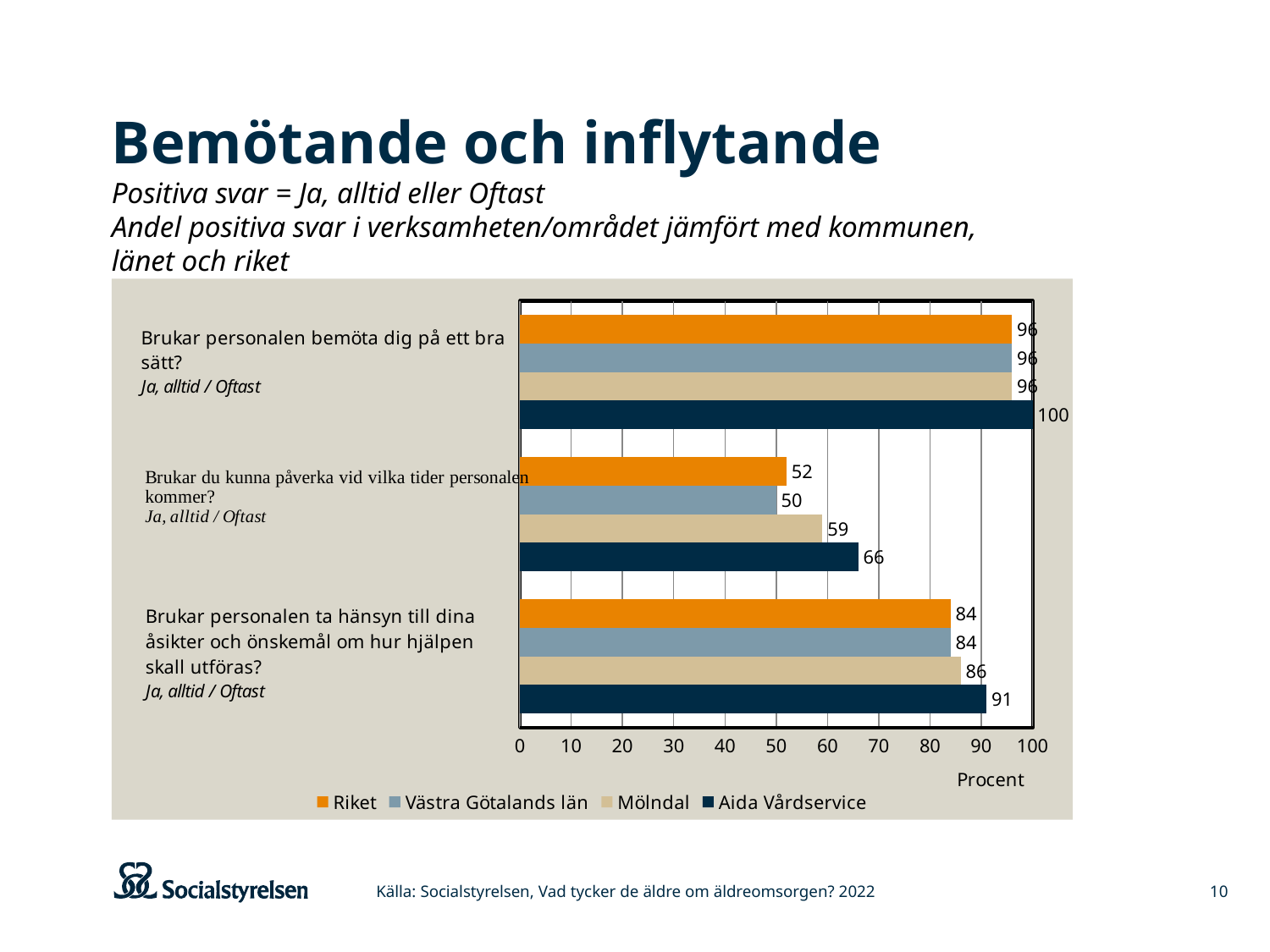
What is the value for Mölndal on the question "Brukar personalen ta hänsyn till dina åsikter och önskemål om hur hjälpen skall utföras?"? 86 Which series has the lowest value on the question "Brukar du kunna påverka vid vilka tider personalen kommer?"? Västra Götalands län Which is larger on the question "Brukar du kunna påverka vid vilka tider personalen kommer?": Mölndal or Riket? Mölndal What is the difference between Aida Vårdservice and Riket on the question "Brukar personalen ta hänsyn till dina åsikter och önskemål om hur hjälpen skall utföras?"? 7 How many series does the legend list? 4 What is the value for Riket on the question "Brukar personalen bemöta dig på ett bra sätt?"? 96 Which series has the highest value on the question "Brukar du kunna påverka vid vilka tider personalen kommer?"? Aida Vårdservice What kind of chart is shown on the slide? Bar chart What is the value for Västra Götalands län on the question "Brukar du kunna påverka vid vilka tider personalen kommer?"? 50 What is the value for Aida Vårdservice on the question "Brukar du kunna påverka vid vilka tider personalen kommer?"? 66 What is the difference between Aida Vårdservice and Mölndal on the question "Brukar personalen bemöta dig på ett bra sätt?"? 4 What is the label on the horizontal axis of the chart? Procent